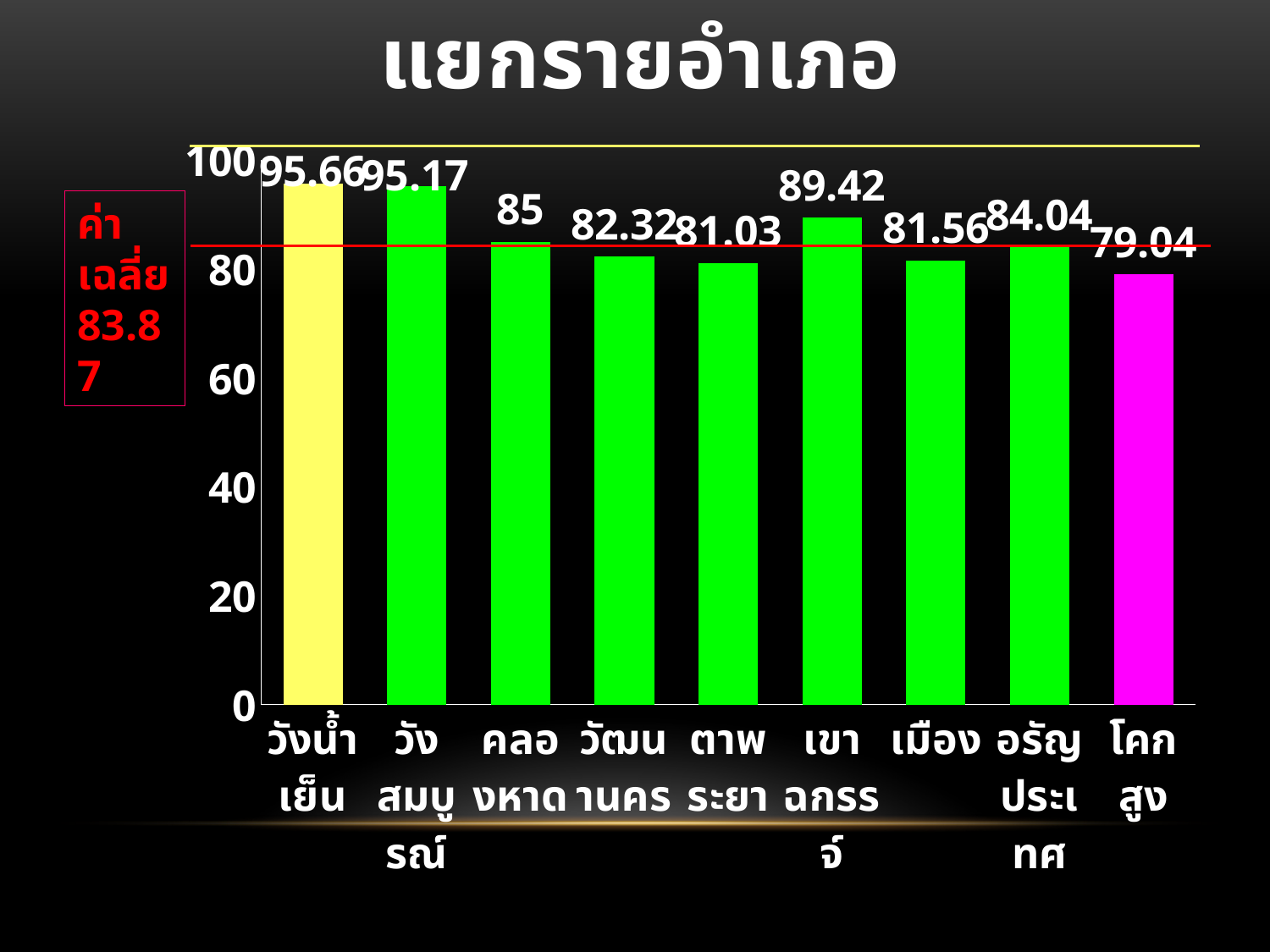
What is the value for เขาฉกรรจ์? 89.42 What is the value for คลองหาด? 85 Which is larger, the value for เขาฉกรรจ์ or the value for อรัญประเทศ? เขาฉกรรจ์ What colour is the bar for โคกสูง? magenta Which district has the lowest value? โคกสูง What is the difference between the values for วังน้ำเย็น and โคกสูง? 16.62 Which district has the highest value? วังน้ำเย็น What average value (ค่าเฉลี่ย) is shown in the red box on the slide? 83.87 What is the value for โคกสูง? 79.04 What is the value for วังน้ำเย็น? 95.66 How many districts are shown on the chart? 9 What kind of chart is shown on the slide? bar chart